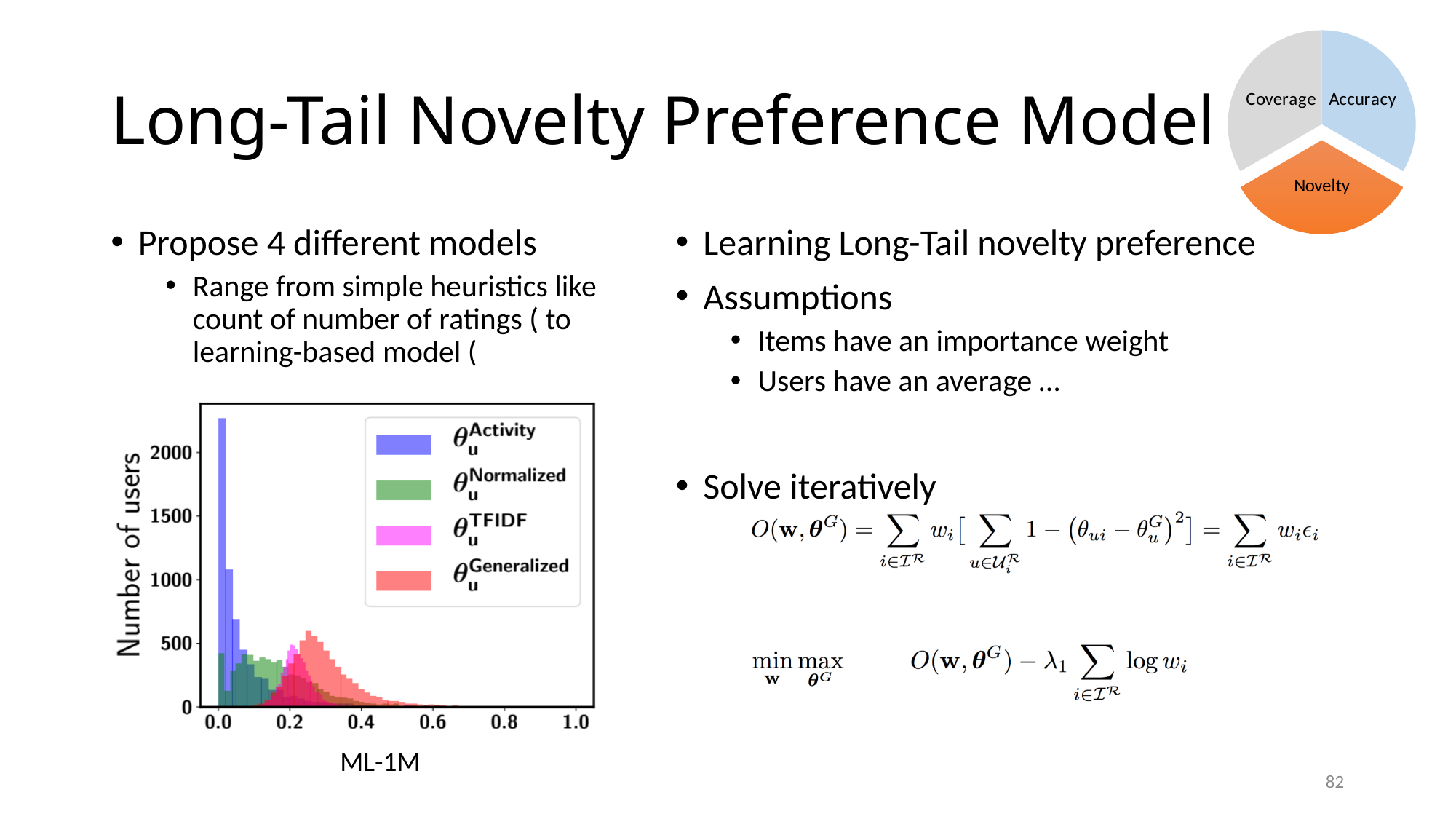
In the ML-1M chart, which series has a higher peak: θ_u^Activity or θ_u^Generalized? θ_u^Activity What are the labels of the three slices in the pie chart in the top-right corner? Coverage, Accuracy, Novelty In the ML-1M chart, is the tallest bar of the θ_u^Activity series greater or less than 2000 users? greater What kind of chart is the ML-1M chart on the left of the slide? Histogram (bar chart) In the ML-1M chart, is the tallest bar of the θ_u^Normalized series greater or less than 500 users? less In the ML-1M chart, what colour represents the θ_u^Generalized series? Red How many slices does the pie chart in the top-right corner have? 3 In the ML-1M chart, is the tallest bar of the θ_u^Generalized series greater or less than 1000 users? less In the ML-1M chart on the left, how many series does the legend list? 4 In the ML-1M chart, which series reaches the highest number of users in a single bin? θ_u^Activity What kind of chart is shown in the top-right corner of the slide? Pie chart What is the label of the y axis in the ML-1M chart? Number of users